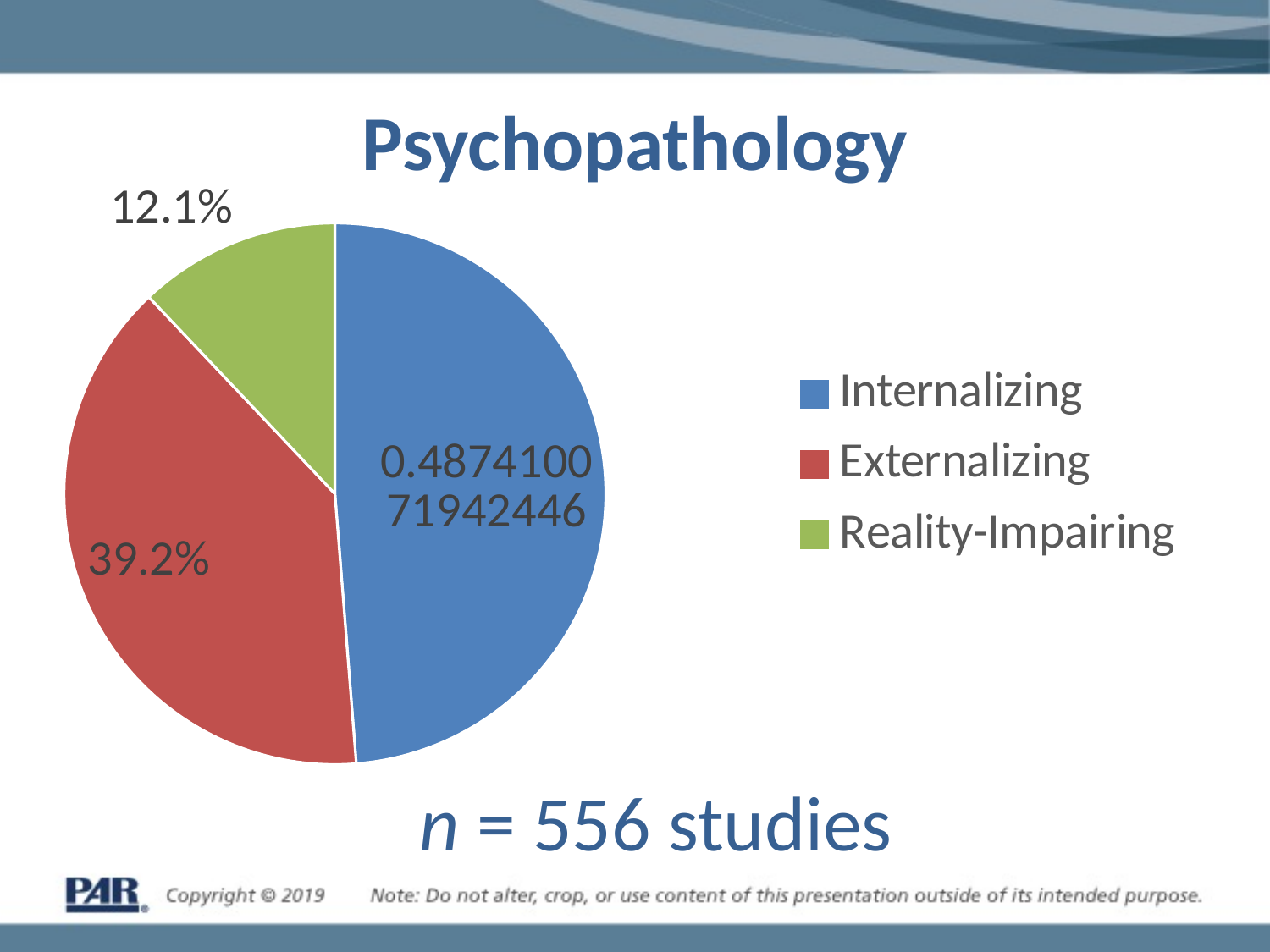
Which category has the smallest slice of the pie? Reality-Impairing What share of the pie does the Externalizing slice represent? 39.2% What colour is the Reality-Impairing slice? green What is the difference in percentage points between the Externalizing and Reality-Impairing slices? 27.1% What share of the pie does the Reality-Impairing slice represent? 12.1% Which slice is larger, Externalizing or Reality-Impairing? Externalizing What is the title of the chart? Psychopathology How many slices does the pie chart have? 3 What kind of chart is shown on the slide? pie chart How many entries does the legend list? 3 Which category has the largest slice of the pie? Internalizing What value is printed on the Internalizing slice? 0.487410071942446